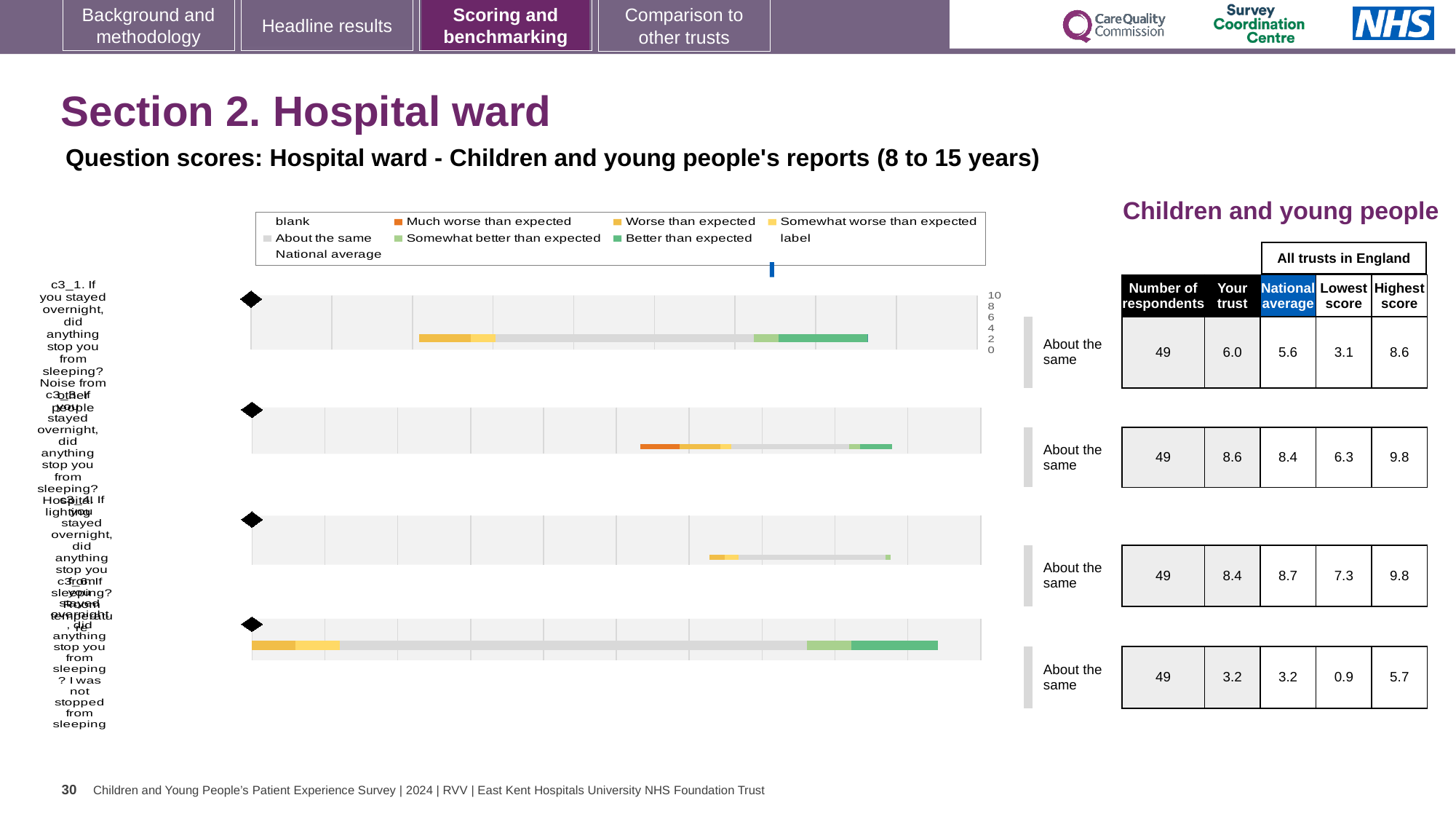
What is the national average for the second chart from the top? 8.4 For the top chart, what is the difference between the highest score and the lowest score in England? 5.5 For the top chart, which is larger: the 'Your trust' score or the national average? Your trust What is the number of respondents for the top chart? 49 What kind of chart is used to show the question scores on this slide? bar chart What is the highest score in England for the bottom chart? 5.7 Which chart has the lowest 'Your trust' score? the bottom chart (3.2) What is the 'Your trust' score for the top chart? 6.0 What colour represents 'Much worse than expected' in the legend? orange What benchmark category is shown next to each of the four charts? About the same How many question charts are shown on the slide? 4 Which chart has the highest 'Your trust' score? the second chart from the top (8.6)